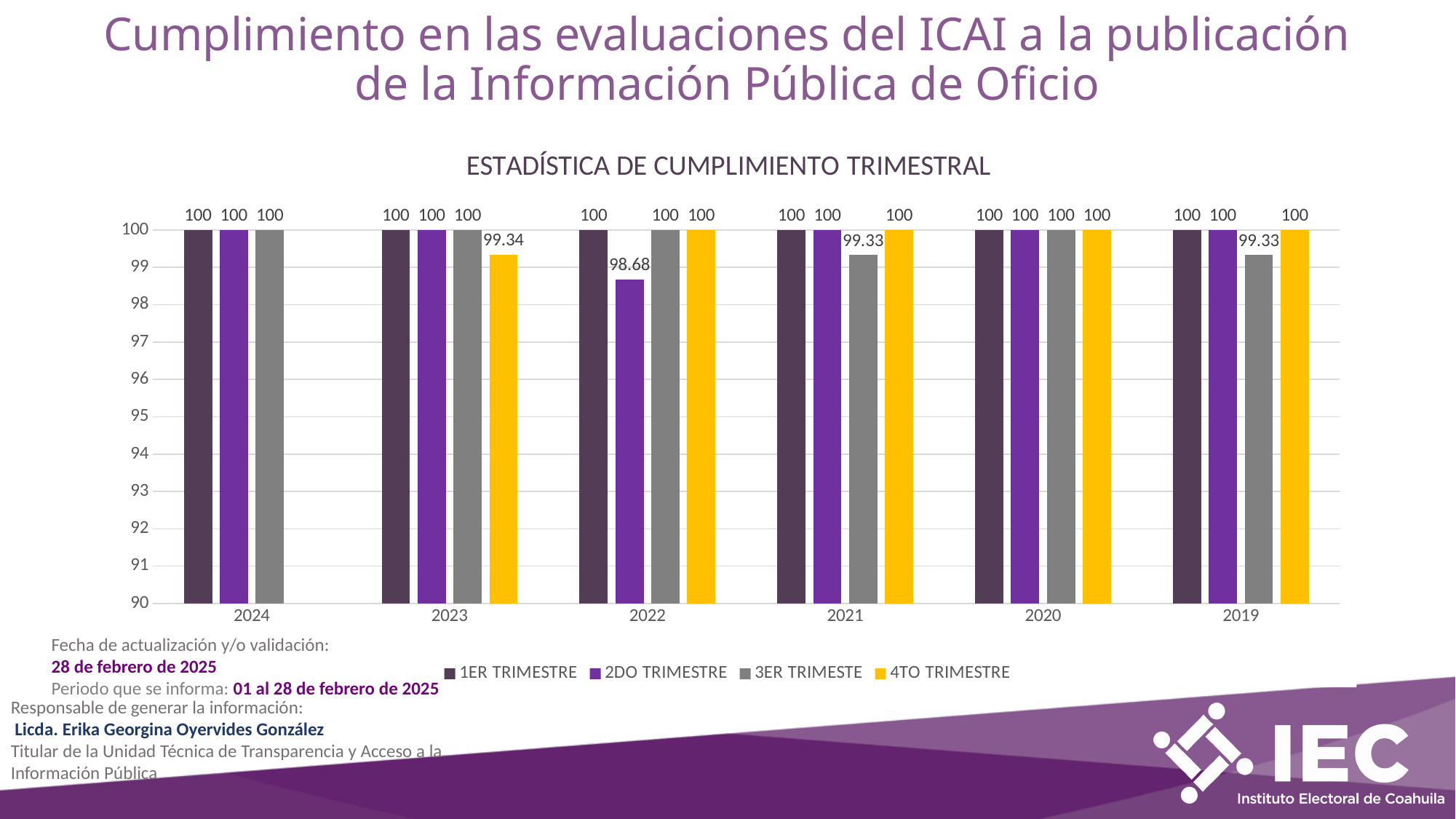
What is the value for 3ER TRIMESTE in 2021? 99.33 Which year has no 4TO TRIMESTRE bar? 2024 What is the value for 4TO TRIMESTRE in 2023? 99.34 What is the difference between the 1ER TRIMESTRE and 2DO TRIMESTRE values in 2022? 1.32 Which year has the lowest single bar value in the chart? 2022 What is the value for 2DO TRIMESTRE in 2022? 98.68 How many series does the legend list? 4 What is the title of the chart? ESTADÍSTICA DE CUMPLIMIENTO TRIMESTRAL Which is larger in 2021: the 3ER TRIMESTE value or the 4TO TRIMESTRE value? 4TO TRIMESTRE What type of chart is shown on the slide? bar chart How many years are shown on the x axis? 6 What is the value for 1ER TRIMESTRE in 2020? 100